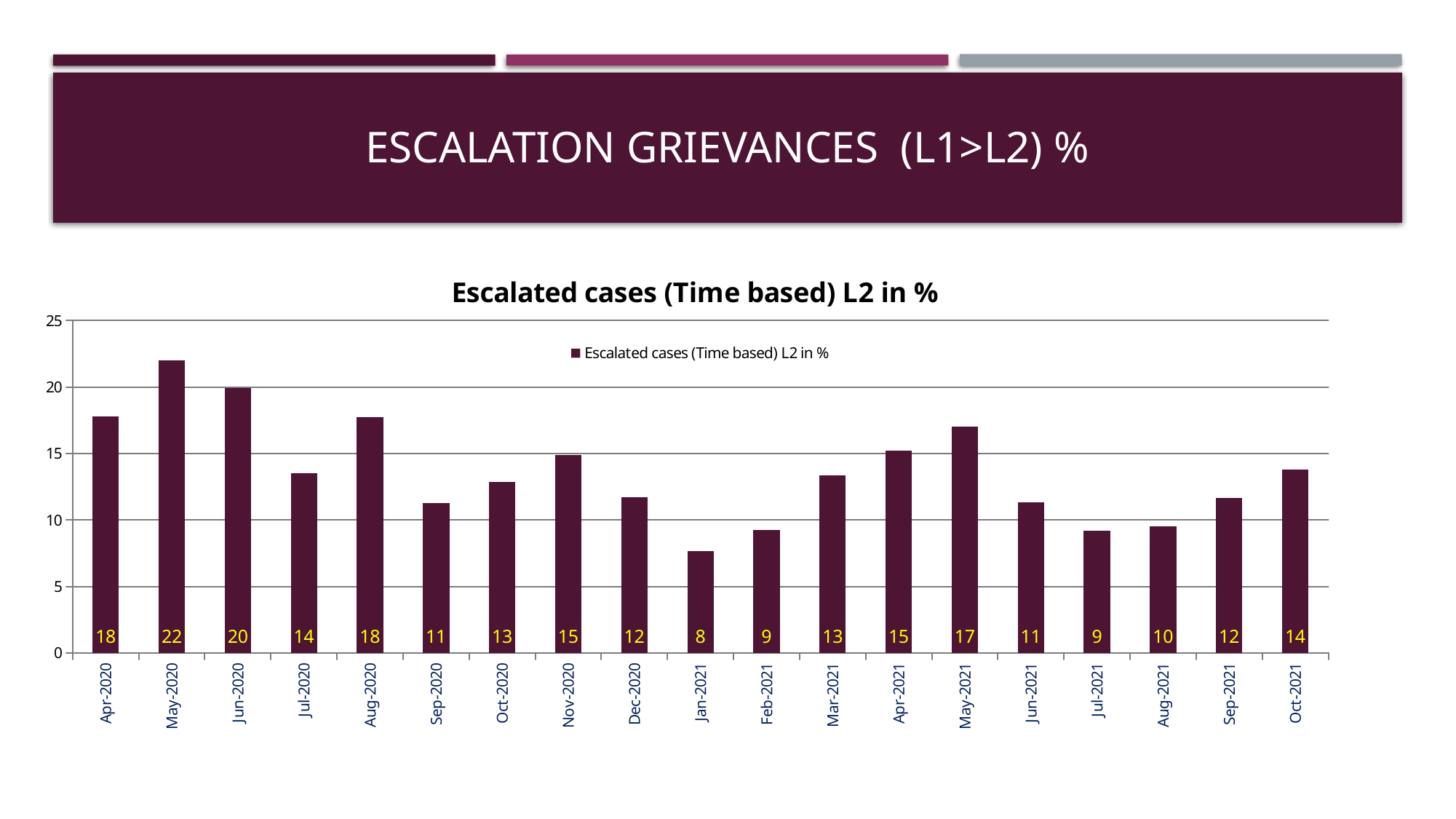
Which month has the highest value? May-2020 What kind of chart is shown? bar chart What is the value for May-2020? 22 Is the value for Jun-2020 greater or less than 15? greater What is the value for Oct-2021? 14 What is the value for Jan-2021? 8 How many months are shown on the x axis? 19 Which month has the lowest value? Jan-2021 How many series does the legend list? 1 What is the title of the chart? Escalated cases (Time based) L2 in % Which is larger, the value for Apr-2021 or the value for Jun-2021? Apr-2021 What is the difference between the values for May-2020 and Jan-2021? 14